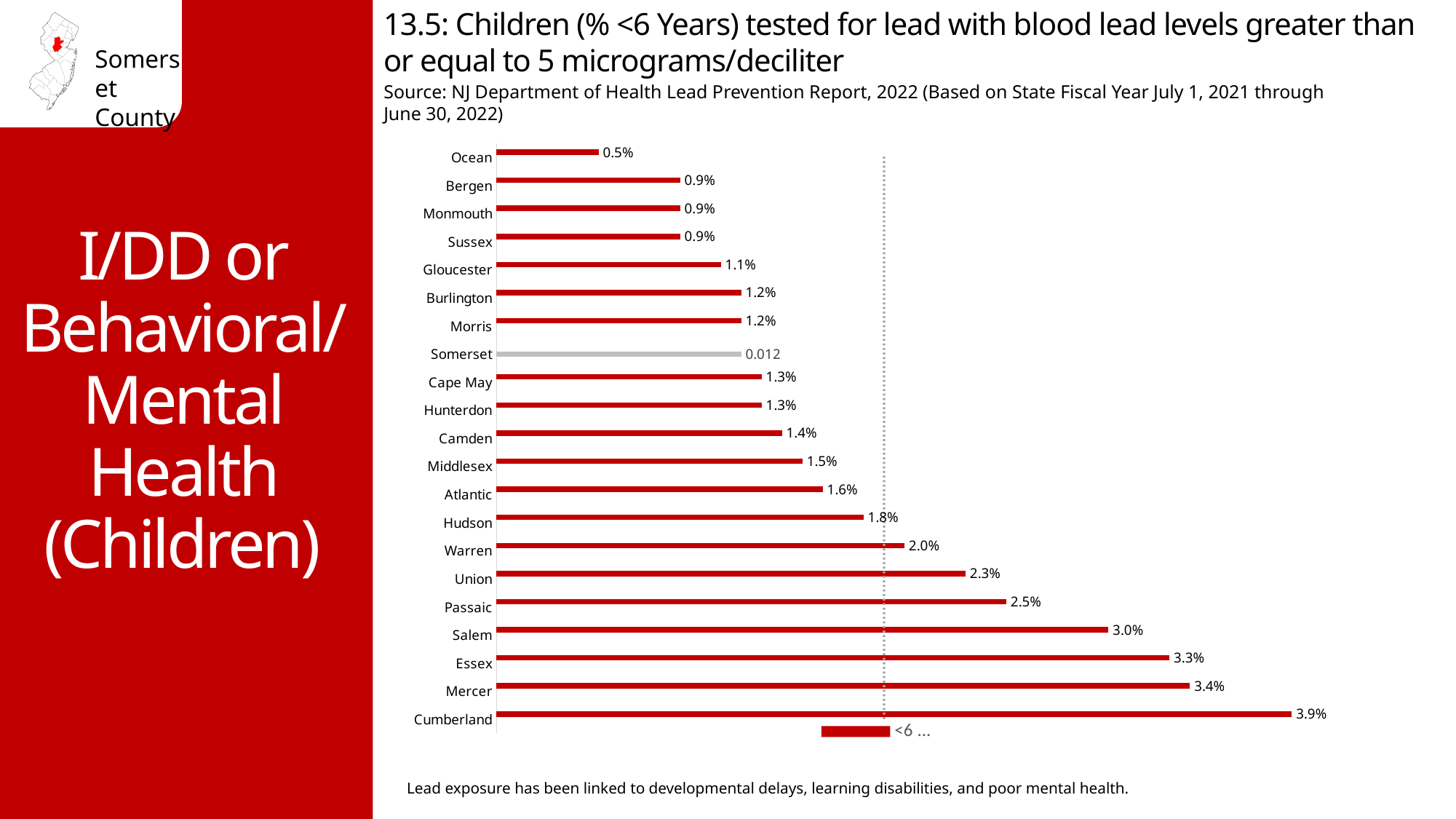
What kind of chart is shown on the slide? Bar chart Which county has the highest value? Cumberland What value is shown for Somerset? 0.012 Which county's bar is shown in gray rather than red? Somerset What is the difference between the values for Mercer and Essex? 0.1% Which county has the lowest value? Ocean Which has a larger value, Salem or Passaic? Salem What is the difference between the values for Cumberland and Ocean? 3.4% What is the value for Hudson? 1.8% How many counties are shown in the chart? 21 What is the value for Ocean? 0.5% What is the value for Cumberland? 3.9%